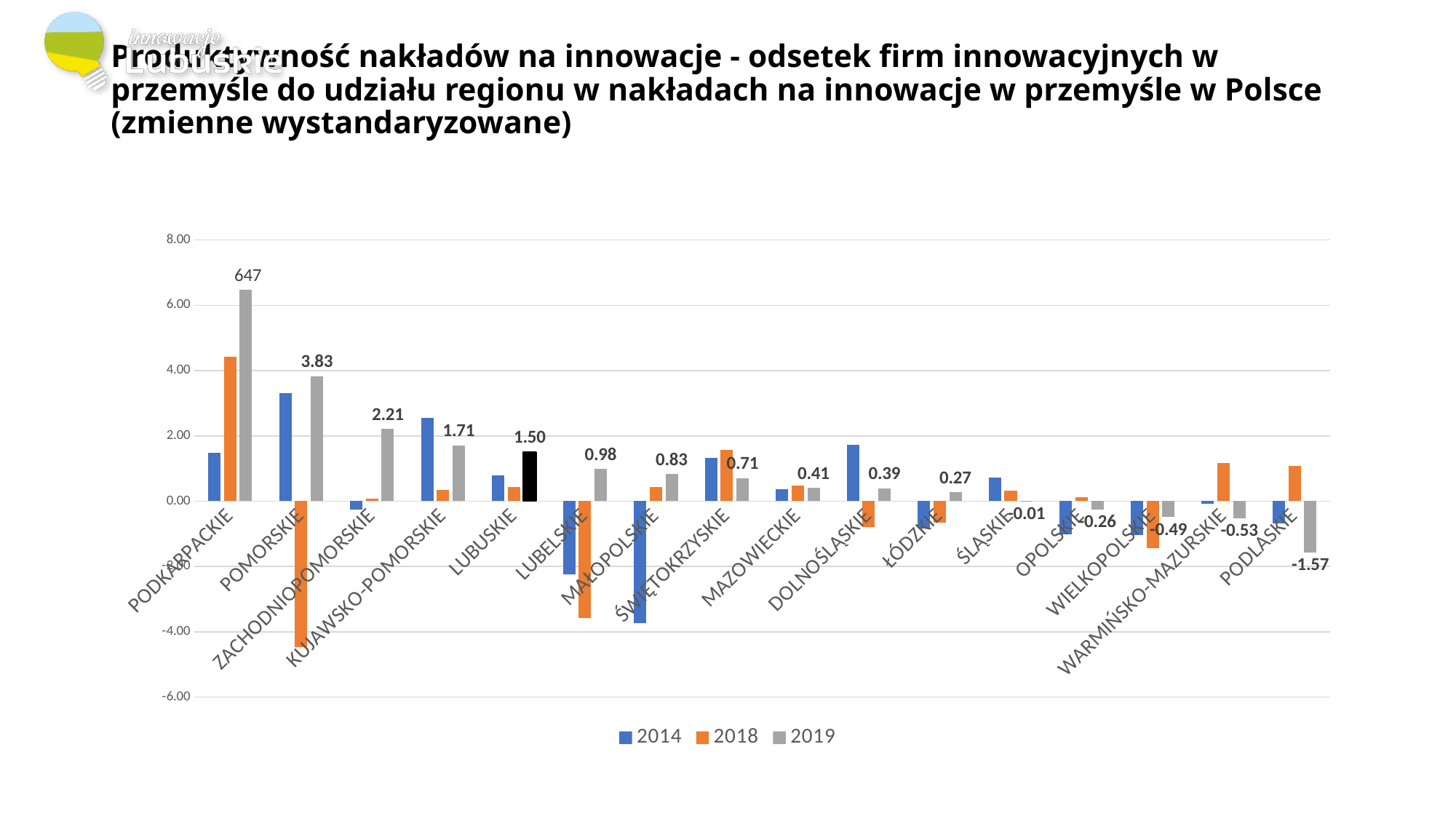
Which region has the highest 2019 value? PODKARPACKIE Which region has the lowest 2019 value? PODLASKIE What is the difference between the 2019 values for ZACHODNIOPOMORSKIE and KUJAWSKO-POMORSKIE? 0.50 Is the 2018 value for PODKARPACKIE greater or less than 4.00? greater What is the 2019 value for MAZOWIECKIE? 0.41 How many series does the legend list? 3 Which is larger, the 2019 value for LUBELSKIE or for MAŁOPOLSKIE? LUBELSKIE What is the 2019 value for PODLASKIE? -1.57 What kind of chart is shown on the slide? bar chart How many regions are shown on the x axis? 16 What is the 2019 value for LUBUSKIE? 1.50 What is the 2019 value for POMORSKIE? 3.83